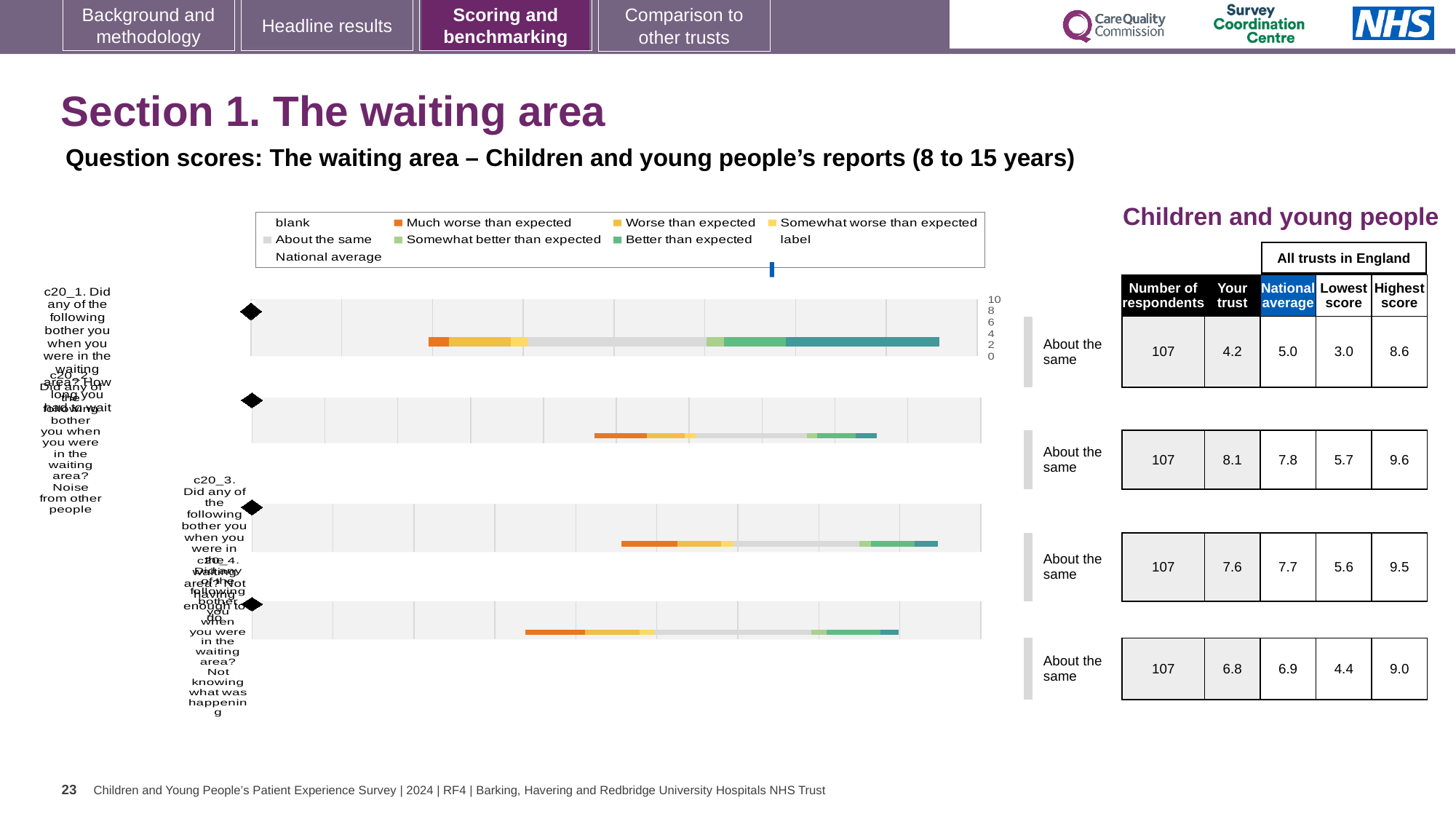
How many entries does the chart legend list? 9 What colour does the legend use for 'Much worse than expected'? orange In the table next to the charts, what is the Lowest score for the third question? 5.6 How many question score bars are plotted on the slide? 4 For the second question, which is larger: the 'Your trust' score or the National average? Your trust How many respondents are listed for each question in the table? 107 In the table next to the charts, what is the Highest score for the fourth (bottom) question? 9.0 For the first (top) question, what is the difference between the National average and the 'Your trust' score? 0.8 What kind of chart is used to show the question scores on this slide? bar chart Which question row has the highest 'Your trust' score in the table? the second question (8.1) In the table next to the charts, what is the National average for the second question? 7.8 In the table next to the charts, what is the 'Your trust' score for the first (top) question? 4.2